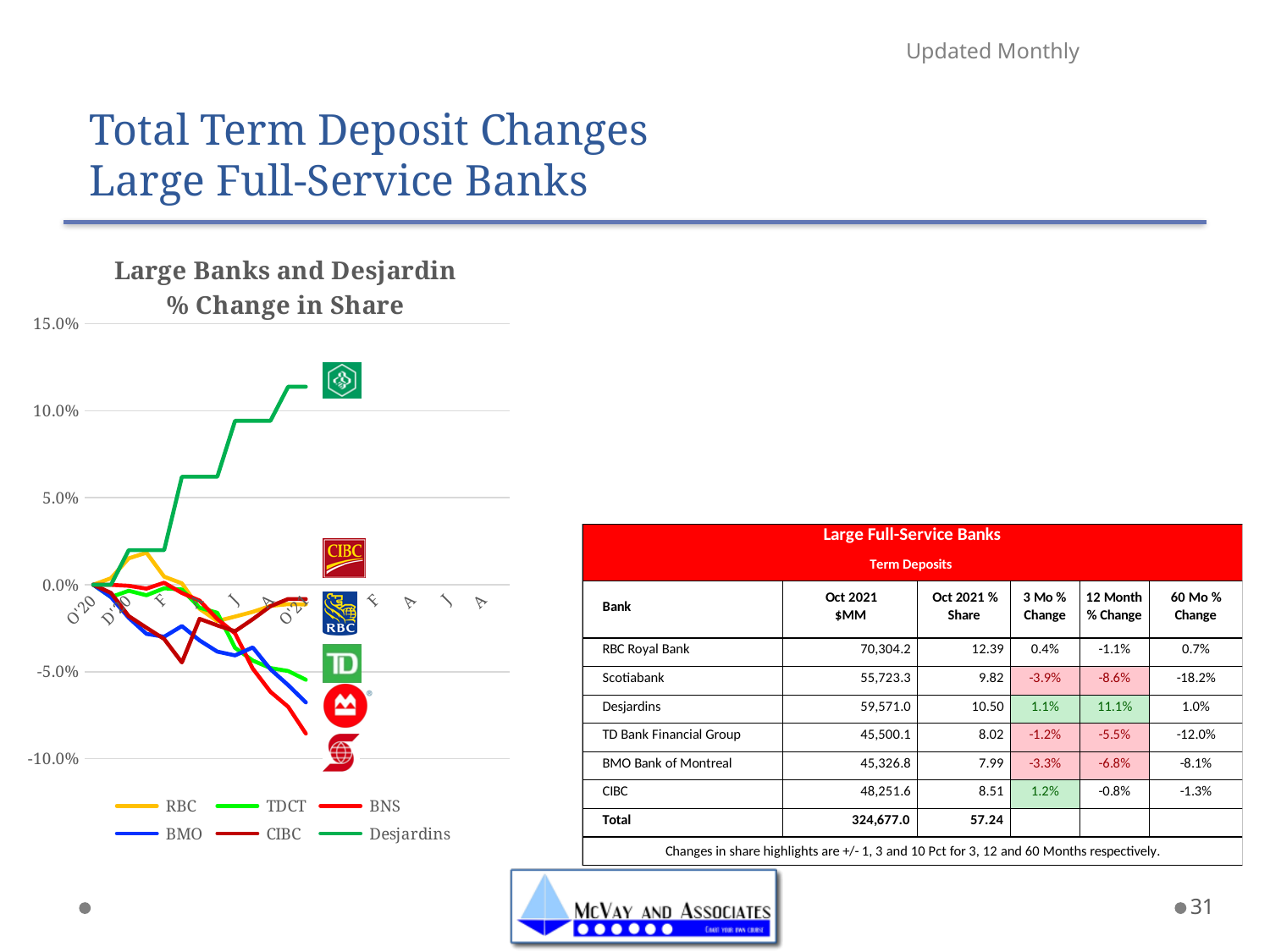
Which series has the lowest value at the end of the chart (O'21)? BNS What is the highest value shown on the chart's y axis? 15.0% Does the Desjardins line rise or fall from O'20 to O'21? rise Does the BNS line rise or fall from O'20 to O'21? fall Is the value for Desjardins at the end of the chart (O'21) greater or less than 10.0%? greater How many series does the chart's legend list? 6 What kind of chart is shown on the slide? line chart Is the value for BMO at the end of the chart (O'21) greater or less than -5.0%? less At the end of the chart (O'21), which is larger: the value for Desjardins or the value for BMO? Desjardins Is the value for BNS at the end of the chart (O'21) greater or less than -5.0%? less Which series has the highest value at the end of the chart (O'21)? Desjardins What is the title of the chart? Large Banks and Desjardin % Change in Share